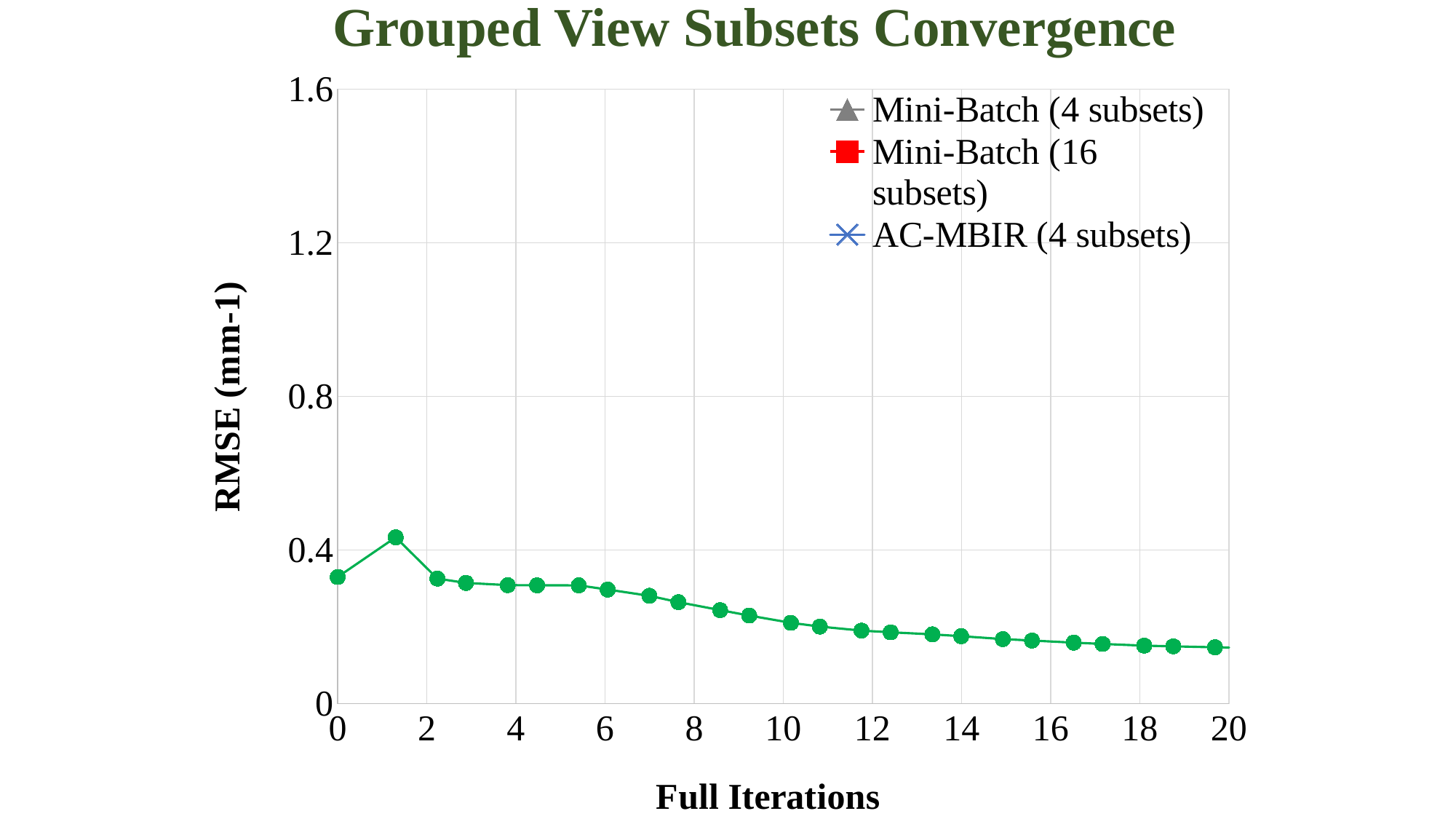
What is the title of the chart? Grouped View Subsets Convergence Is the RMSE value at 0 full iterations greater or less than 0.4? less Is the RMSE value at the last plotted point (near 20 full iterations) greater or less than 0.4? less What is the label of the y axis? RMSE (mm-1) Is the RMSE value at the last plotted point (near 20 full iterations) greater or less than 0? greater What kind of chart is shown on the slide? line chart Which is larger, the RMSE value at 0 full iterations or the RMSE value at the last plotted point near 20 full iterations? the value at 0 full iterations Is the peak of the plotted line at the first point (0 iterations) or at the second point? the second point Do the plotted RMSE values generally rise or fall as the number of full iterations increases from 2 to 20? fall How many series does the chart's legend list? 3